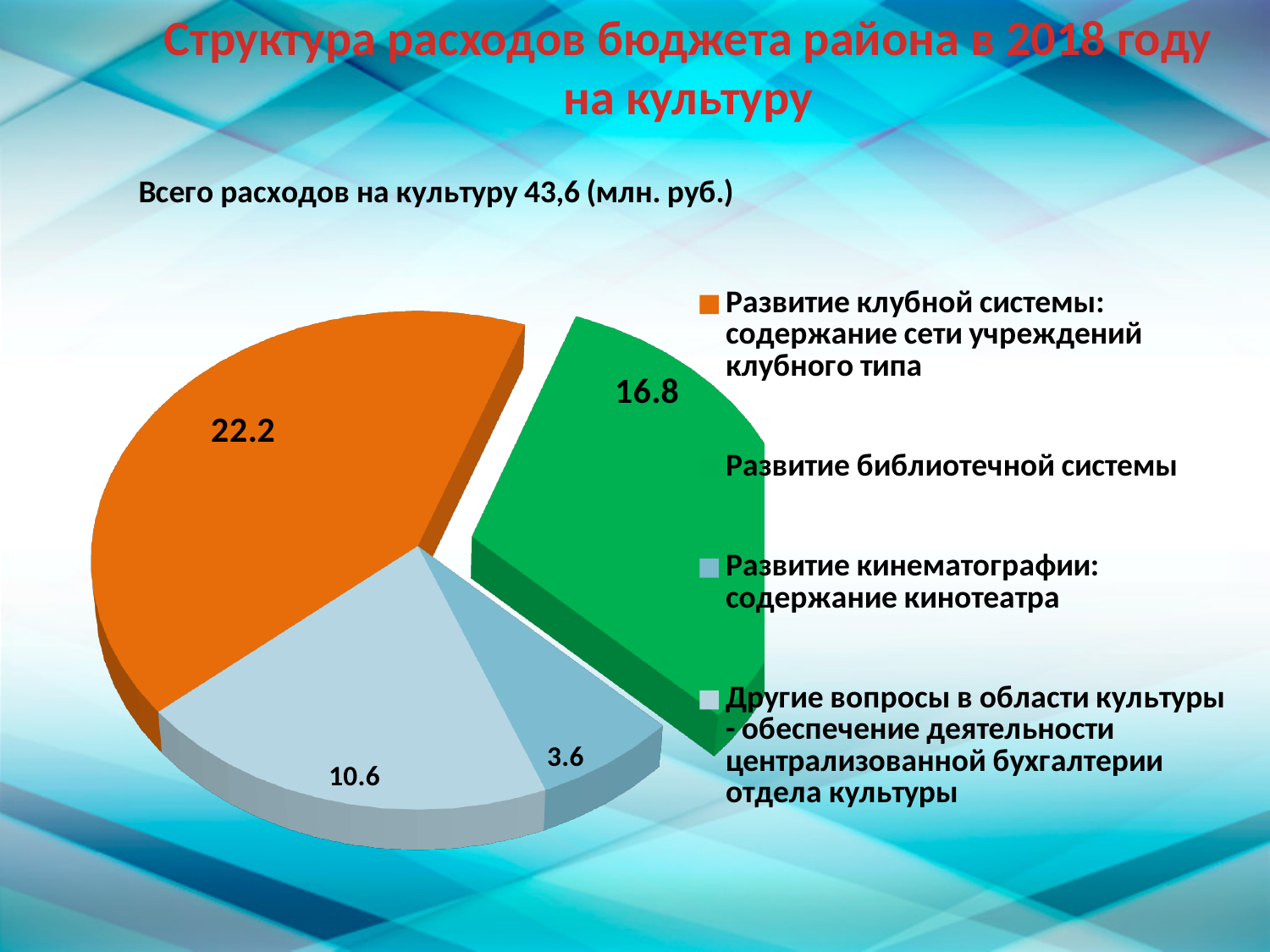
What is the value for "Развитие клубной системы: содержание сети учреждений клубного типа"? 22.2 What colour is the slice for "Развитие клубной системы: содержание сети учреждений клубного типа"? orange What is the difference between the values for "Развитие клубной системы" and "Развитие библиотечной системы"? 5.4 What kind of chart is shown on the slide? pie chart How many slices does the pie chart have? 4 What is the value for "Развитие библиотечной системы"? 16.8 What total expenditure on culture is stated on the slide? 43,6 (млн. руб.) Which is larger: the value for "Развитие библиотечной системы" or for "Другие вопросы в области культуры"? Развитие библиотечной системы Which category has the smallest slice of the pie? Развитие кинематографии: содержание кинотеатра What is the value for "Другие вопросы в области культуры - обеспечение деятельности централизованной бухгалтерии отдела культуры"? 10.6 What is the value for "Развитие кинематографии: содержание кинотеатра"? 3.6 Which category has the largest slice of the pie? Развитие клубной системы: содержание сети учреждений клубного типа